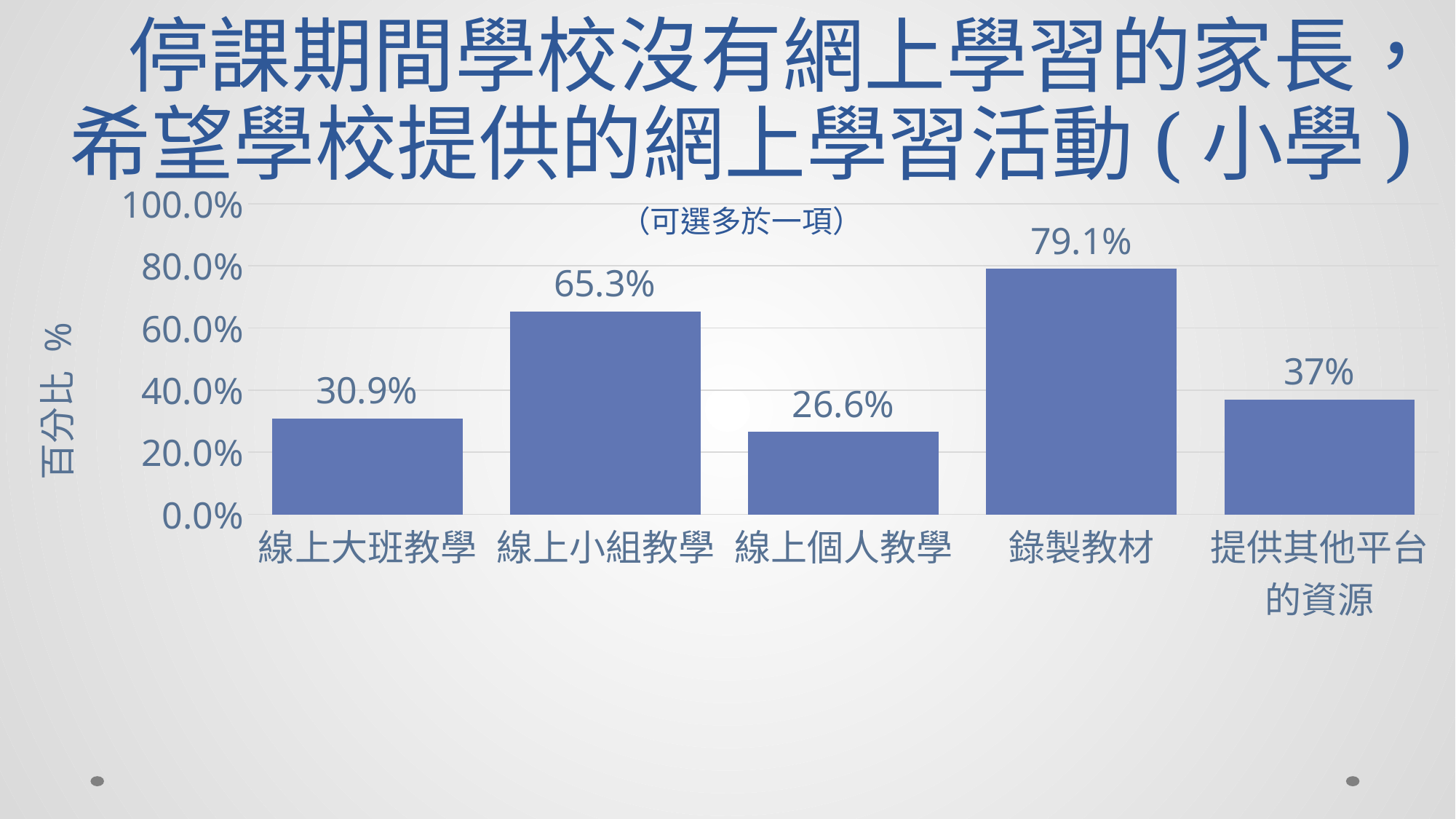
Is the value for 線上小組教學 greater or less than 60.0%? greater Which category has the highest value? 錄製教材 How many categories are shown on the x axis? 5 What is the value for 提供其他平台的資源? 37% Which is larger, the value for 線上大班教學 or 提供其他平台的資源? 提供其他平台的資源 What kind of chart is shown on the slide? bar chart What is the difference between the values for 線上大班教學 and 線上個人教學? 4.3% Which category has the lowest value? 線上個人教學 What is the value for 線上大班教學? 30.9% What is the label of the vertical axis? 百分比 % What is the difference between the values for 錄製教材 and 線上小組教學? 13.8% What is the value for 錄製教材? 79.1%